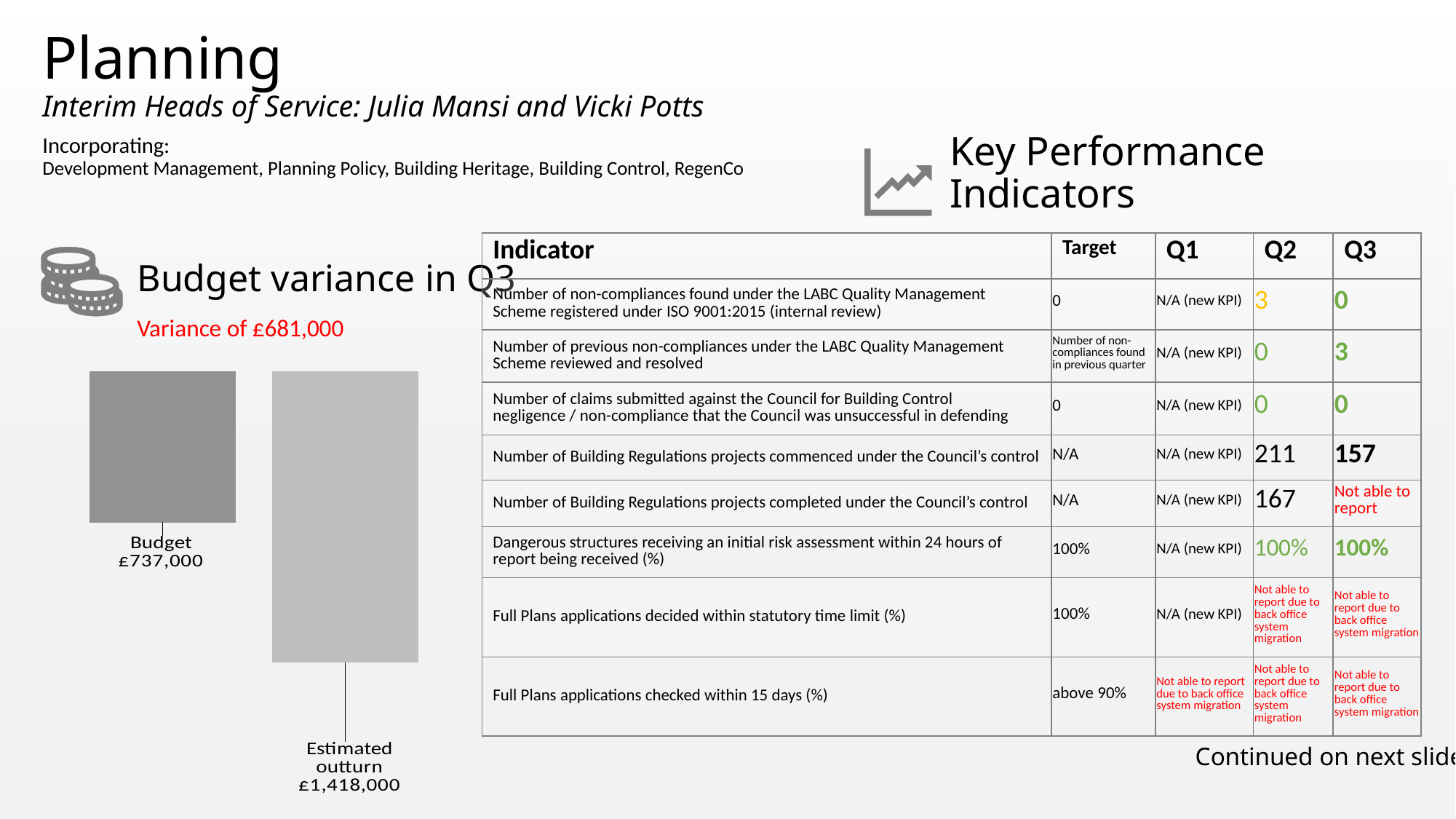
What are the two category labels in the "Budget variance in Q3" chart? Budget and Estimated outturn What variance amount is stated in red text above the "Budget variance in Q3" chart? £681,000 In the "Budget variance in Q3" chart, what is the value for Estimated outturn? £1,418,000 What kind of chart is shown under the heading "Budget variance in Q3"? bar chart How many bars are plotted in the "Budget variance in Q3" chart? 2 In the "Budget variance in Q3" chart, what is the difference between the Estimated outturn and the Budget? £681,000 In the "Budget variance in Q3" chart, which category has the higher value? Estimated outturn In the "Budget variance in Q3" chart, what is the value for Budget? £737,000 In the "Budget variance in Q3" chart, which category has the lower value? Budget In the "Budget variance in Q3" chart, is the Budget bar larger or smaller than the Estimated outturn bar? smaller